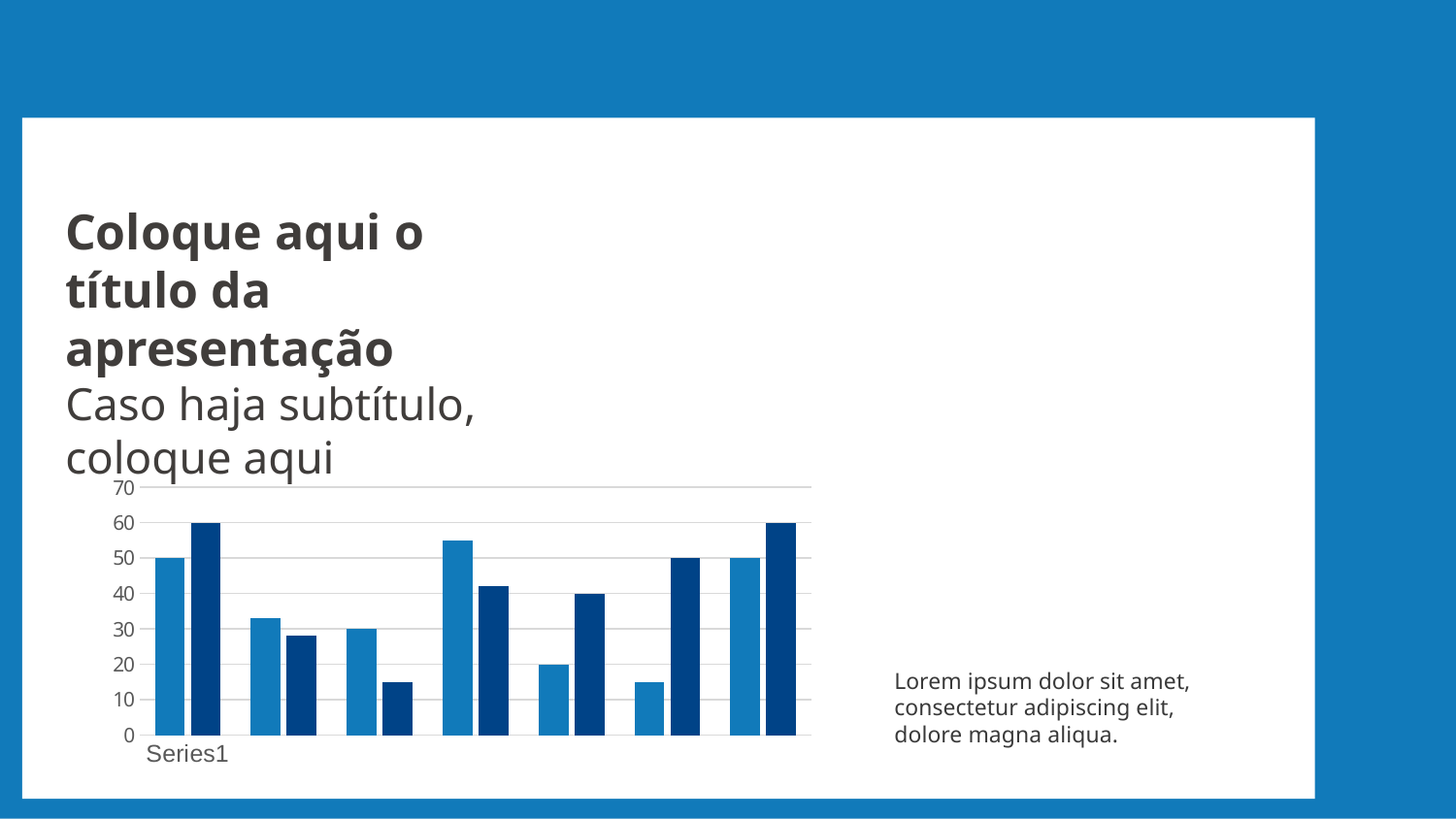
What is the highest value shown on the vertical axis of the chart? 70 What is the value of the dark blue bar in the Series1 group? 60 In the fifth group from the left, which bar is taller, the light blue or the dark blue one? dark blue How many groups of bars are plotted in the chart? 7 What is the only category label shown on the horizontal axis of the chart? Series1 Is the value of the dark blue bar in the third group from the left greater or less than 20? less In the Series1 group, which bar is taller, the light blue or the dark blue one? dark blue Is the value of the light blue bar in the sixth group from the left greater or less than 20? less What kind of chart is shown on the slide? bar chart Is the value of the light blue bar in the fourth group from the left greater or less than 50? greater What is the value of the light blue bar in the Series1 group? 50 How many bars are plotted in total in the chart? 14